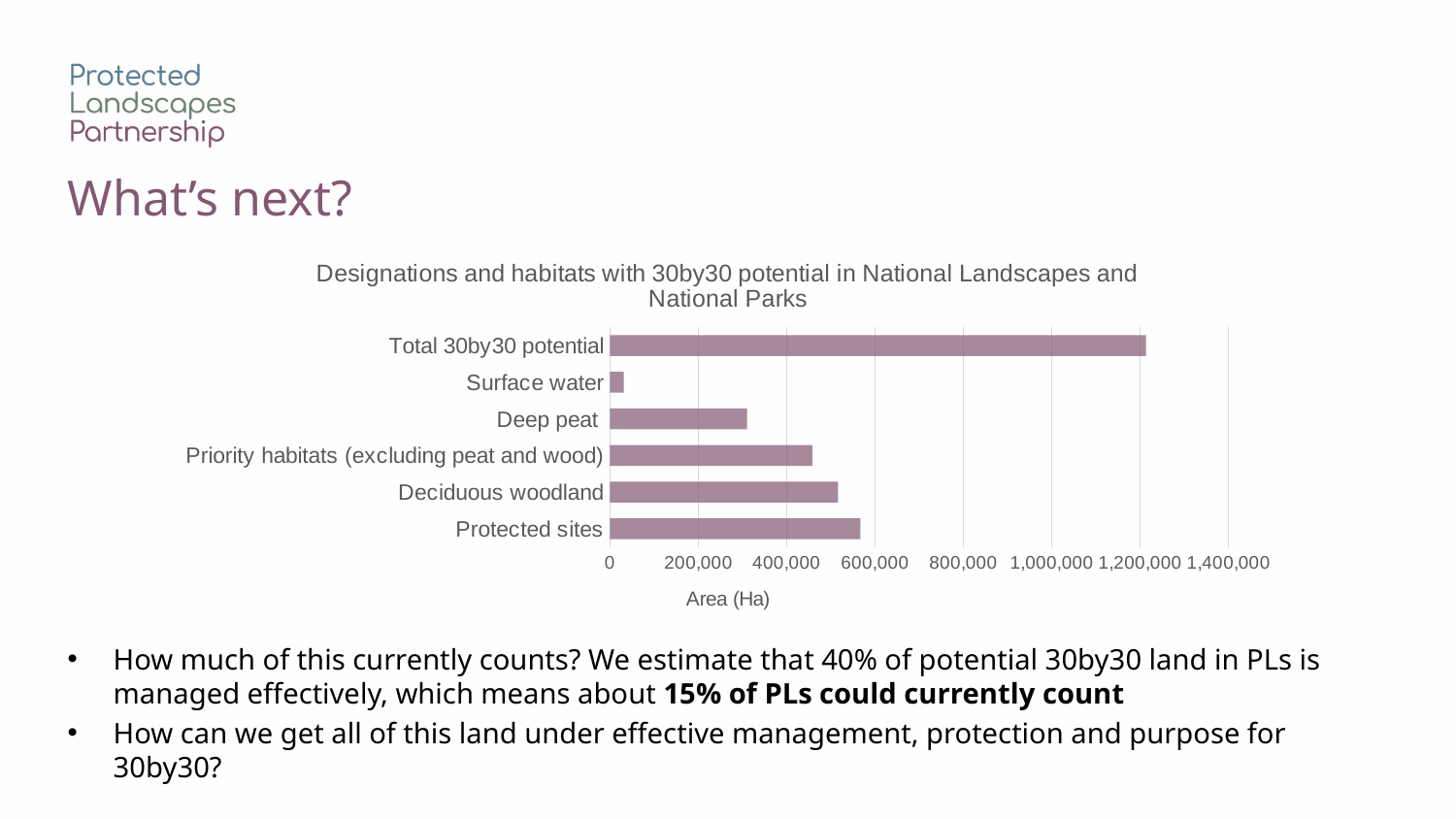
Which is larger, the value for Protected sites or the value for Deep peat? Protected sites Is the value for Surface water greater or less than 200,000? less Is the value for Total 30by30 potential greater or less than 1,000,000? greater Which category has the highest value in the chart? Total 30by30 potential Is the value for Deciduous woodland greater or less than 600,000? less What is the label on the horizontal axis of the chart? Area (Ha) Which category has the lowest value in the chart? Surface water How many categories are plotted in the chart? 6 What kind of chart is shown on the slide? Bar chart What is the title of the chart? Designations and habitats with 30by30 potential in National Landscapes and National Parks